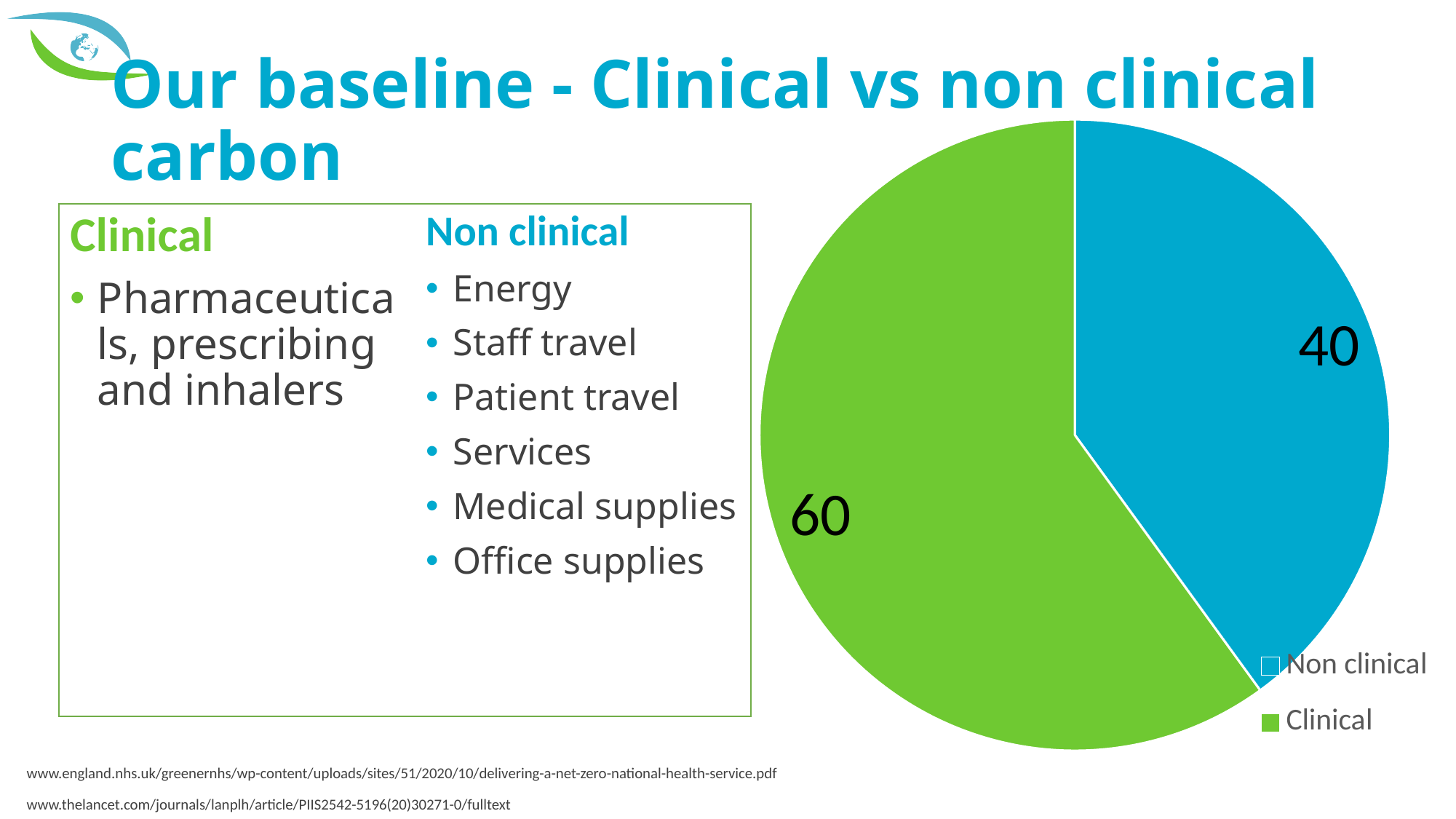
How many entries does the pie chart legend list? 2 What is the difference between the Clinical and Non clinical values in the pie chart? 20 Which slice of the pie chart is the largest? Clinical What is the value for Clinical in the pie chart? 60 What colour is the Clinical slice in the pie chart? green Which slice of the pie chart is the smallest? Non clinical What share of the pie does the Clinical slice represent? 60% What kind of chart is shown on the slide? pie chart How many slices does the pie chart have? 2 Which is larger in the pie chart, Clinical or Non clinical? Clinical What colour is the Non clinical slice in the pie chart? blue What is the value for Non clinical in the pie chart? 40